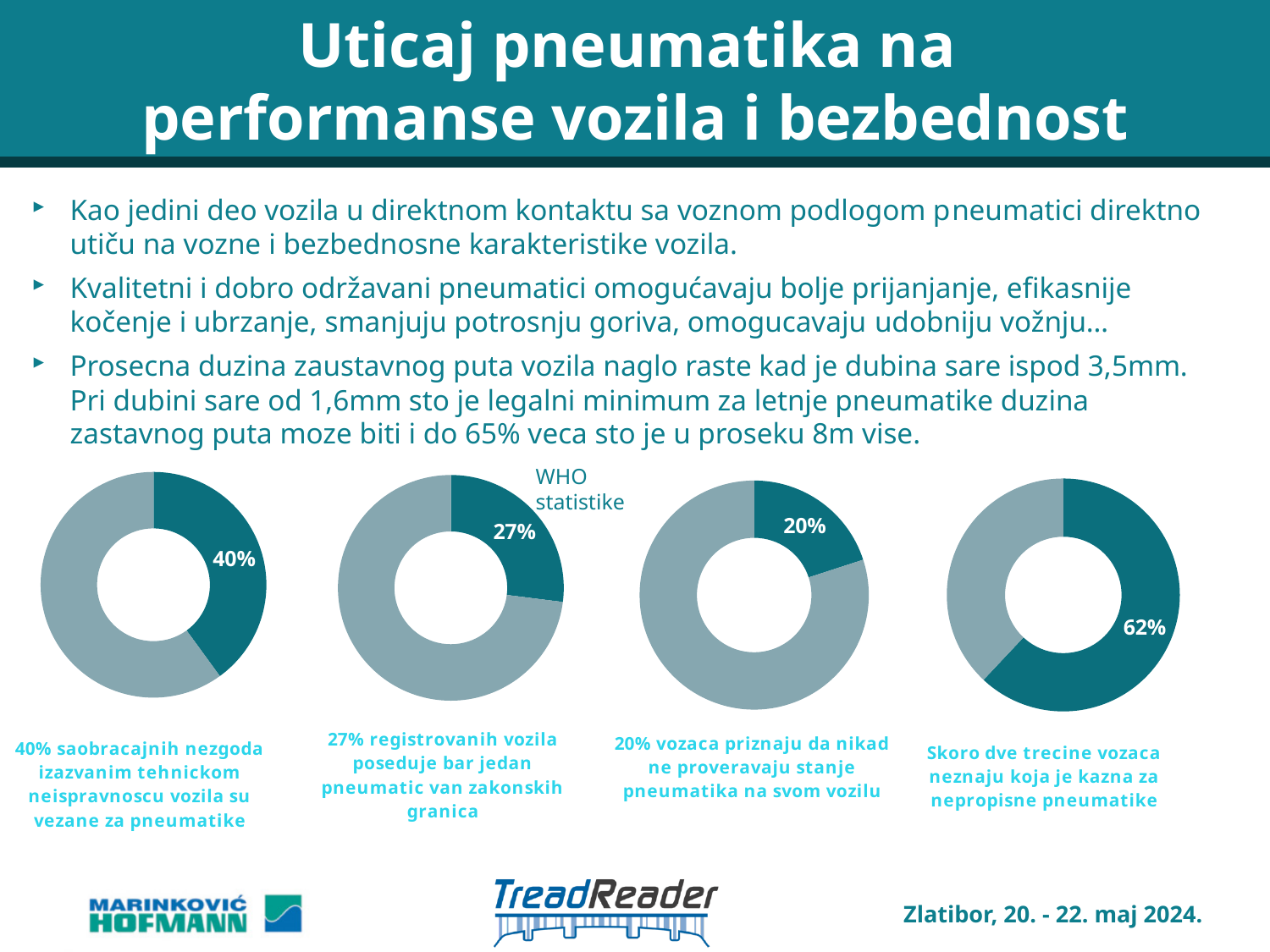
Which donut chart is annotated with the text 'WHO statistike'? the second chart from the left (27%) In the leftmost donut chart, what value is printed on the dark teal slice? 40% In the rightmost donut chart, what value is printed on the dark teal slice? 62% In the second donut chart from the left (labelled 'WHO statistike'), what value is printed on the dark teal slice? 27% Which of the four donut charts has the smallest labelled value? the third chart from the left (20%) How many slices does each donut chart on the slide have? 2 Is the labelled value in the leftmost donut chart larger or smaller than the labelled value in the rightmost donut chart? smaller How many donut charts are shown on the slide? 4 What is the difference between the labelled value in the rightmost donut chart and the labelled value in the leftmost donut chart? 22 percentage points What kind of chart is the leftmost chart on the slide? donut chart In the third donut chart from the left, what value is printed on the dark teal slice? 20% Which of the four donut charts has the largest labelled value? the rightmost chart (62%)